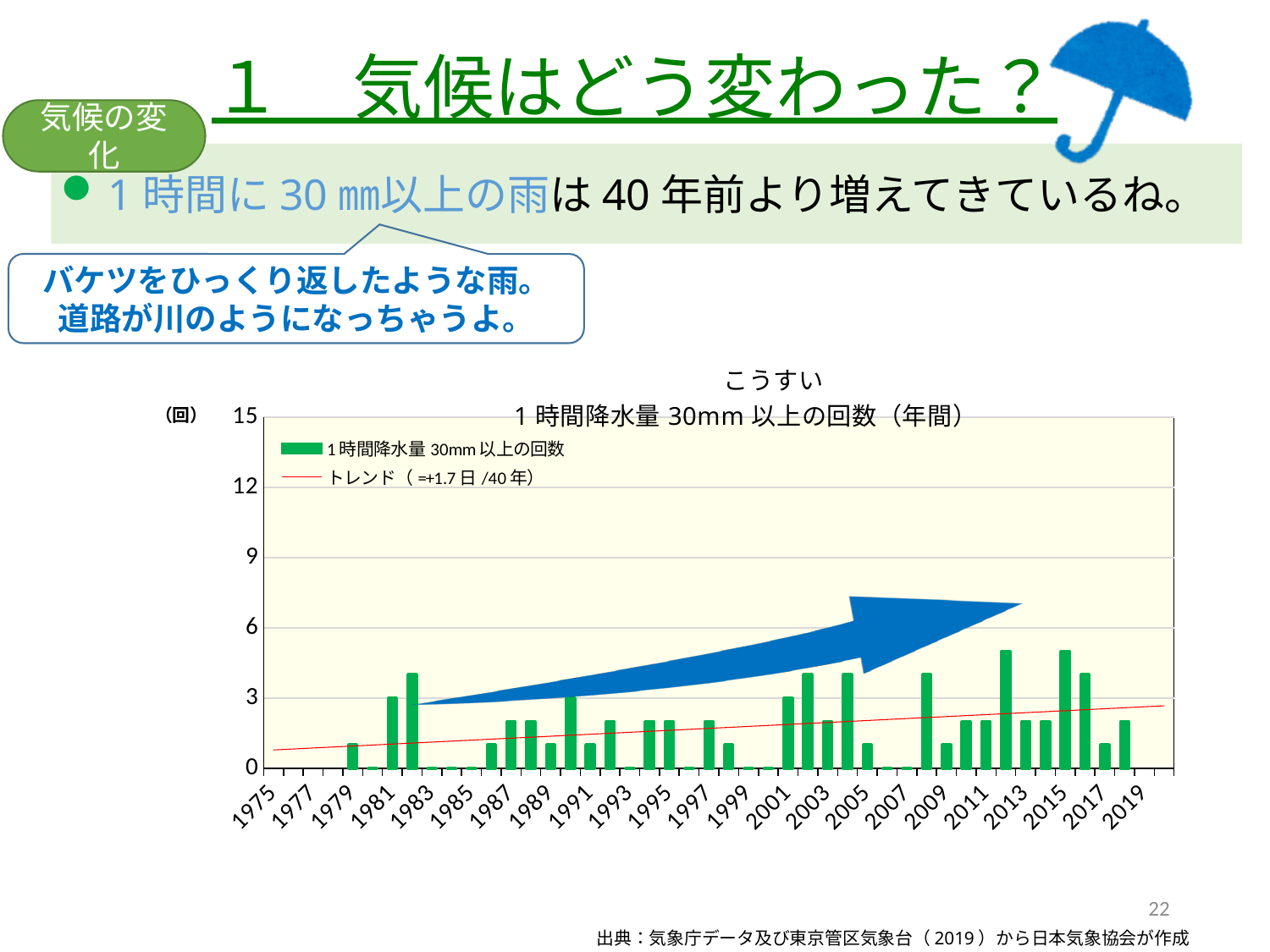
What trend value is given in the legend for the トレンド line? +1.7日/40年 How many series does the chart legend list? 2 Is the value for 2015 greater or less than 3? greater Is the value for 2017 greater or less than 3? less What is the value for 2001? 3 According to the trend line, do the values rise or fall from 1975 to 2019? rise What is the value for 1981? 3 Is the value for 2003 greater or less than 3? less What is the title of the chart? 1時間降水量30mm以上の回数（年間） What kind of chart is shown on the slide? bar chart Which is larger, the value for 2015 or the value for 2003? 2015